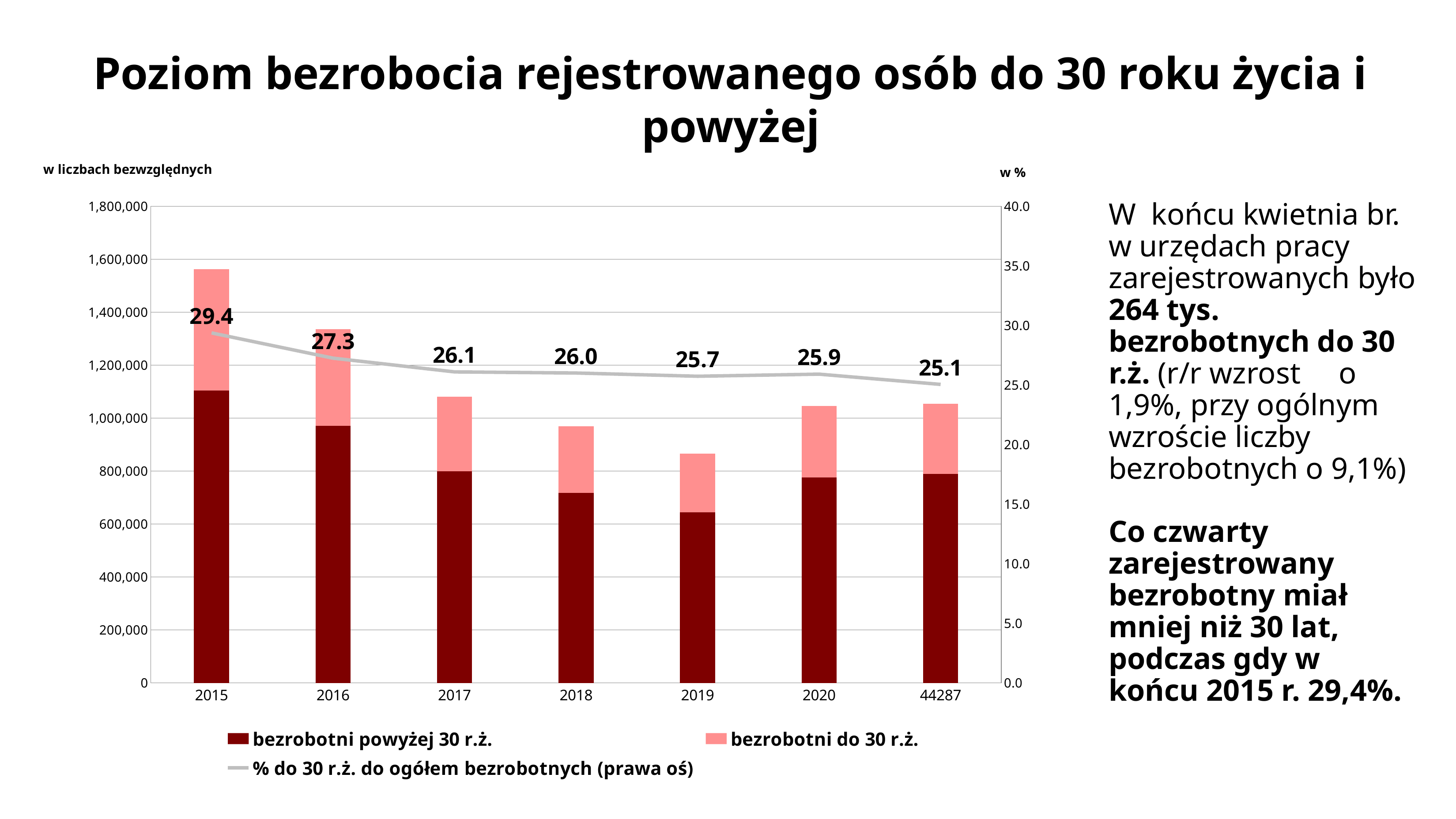
Does the '% do 30 r.ż. do ogółem bezrobotnych' line generally rise or fall from 2015 to the last category? fall How many series does the legend list? 3 Is the 'bezrobotni powyżej 30 r.ż.' value for 2018 greater or less than 800,000? less By how much does the '% do 30 r.ż. do ogółem bezrobotnych' value fall from 2015 to 2016? 2.1 Is the total height of the stacked bar for 2019 greater or less than 1,000,000? less In which year does the '% do 30 r.ż. do ogółem bezrobotnych' line reach its highest value? 2015 What is the lowest value shown on the '% do 30 r.ż. do ogółem bezrobotnych' line? 25.1 Is the total height of the stacked bar for 2015 greater or less than 1,400,000? greater What is the value of the '% do 30 r.ż. do ogółem bezrobotnych' line for 2020? 25.9 What is the value of the '% do 30 r.ż. do ogółem bezrobotnych' line for 2017? 26.1 Which year has the larger '% do 30 r.ż. do ogółem bezrobotnych' value, 2019 or 2020? 2020 What is the value of the '% do 30 r.ż. do ogółem bezrobotnych' line for 2015? 29.4